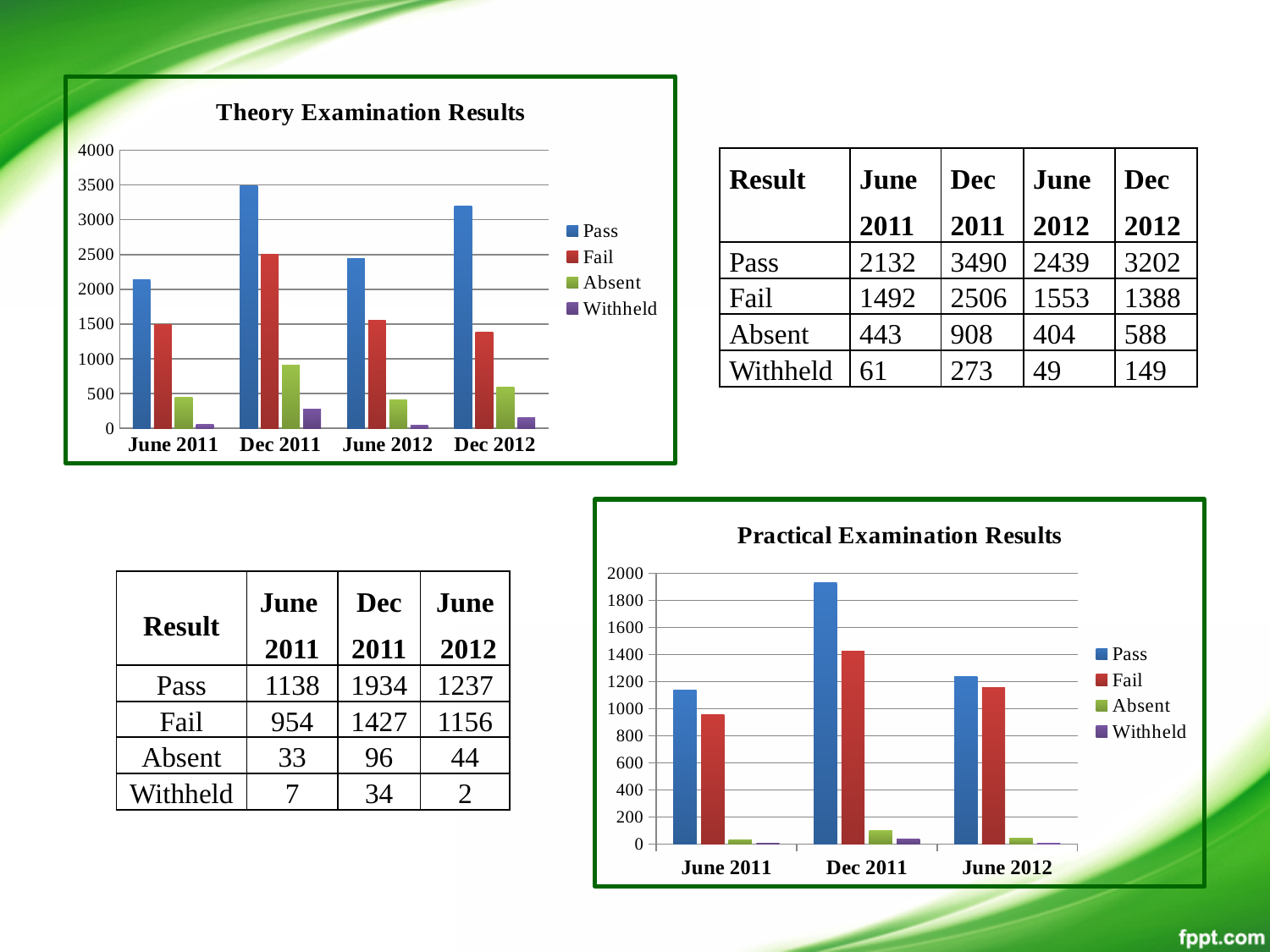
In the Practical Examination Results chart, what is the Fail value for Dec 2011? 1427 What kind of chart is the Practical Examination Results chart? Bar chart In the Theory Examination Results chart, which period has the highest Pass value? Dec 2011 In the Theory Examination Results chart, which period has the lowest Withheld value? June 2012 In the Theory Examination Results chart, what is the Pass value for Dec 2011? 3490 In the Practical Examination Results chart, which is larger for June 2012, Pass or Fail? Pass In the Practical Examination Results chart, how many periods are shown on the x axis? 3 In the Theory Examination Results chart, is the Absent value for Dec 2011 greater or less than 1000? less In the Theory Examination Results chart, what is the difference between the Fail values for Dec 2011 and June 2011? 1014 In the Practical Examination Results chart, which period has the highest Pass value? Dec 2011 In the Practical Examination Results chart, what is the difference between the Pass values for Dec 2011 and June 2011? 796 In the Theory Examination Results chart, how many series does the legend list? 4